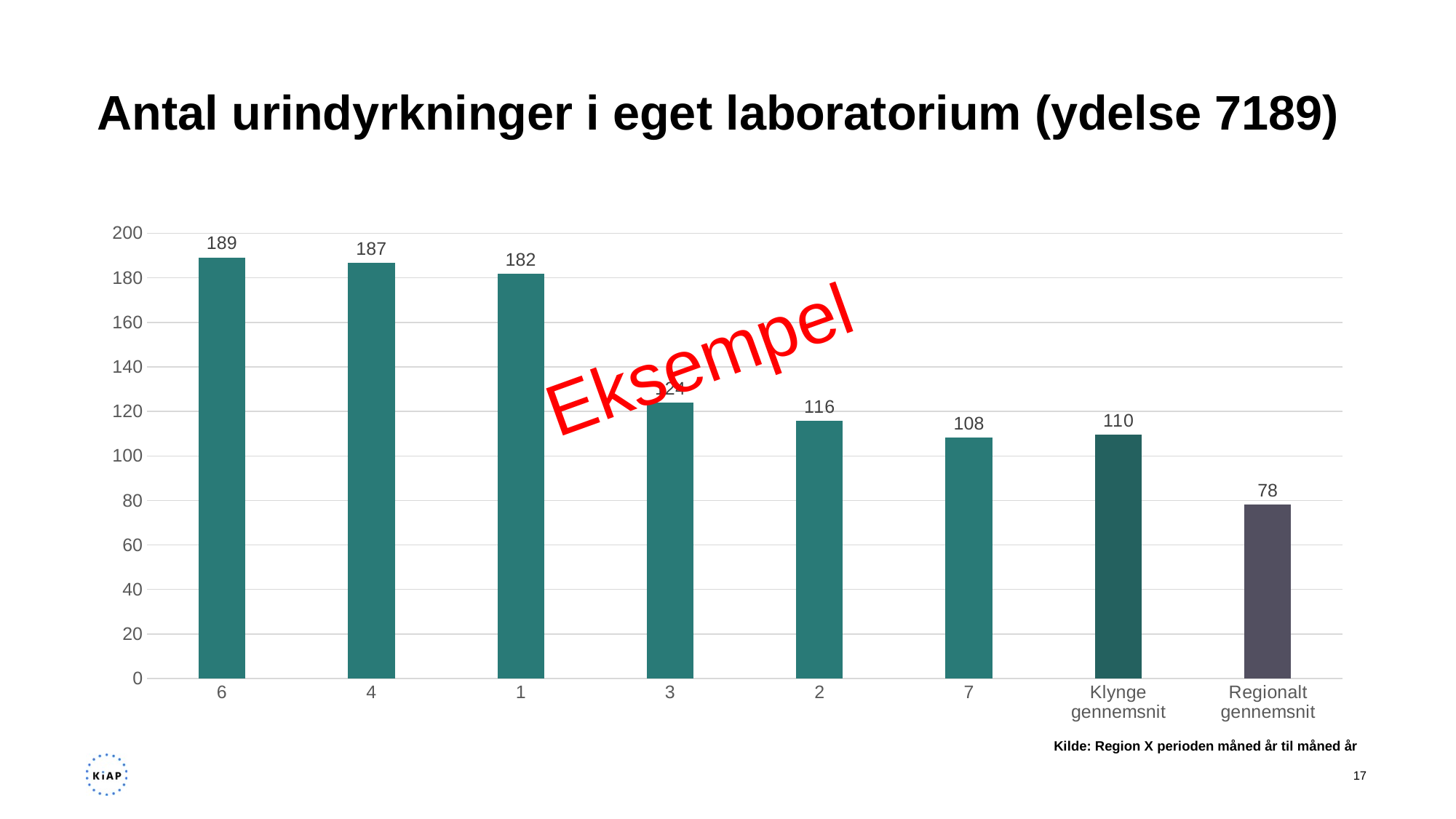
Which category has the lowest value? Regionalt gennemsnit What kind of chart is shown on the slide? bar chart What is the value for category 6? 189 What is the value for Klynge gennemsnit? 110 What is the value for category 2? 116 Which is larger, the value for Klynge gennemsnit or the value for category 7? Klynge gennemsnit What is the difference between the value for category 6 and the value for Regionalt gennemsnit? 111 What is the value for Regionalt gennemsnit? 78 How many bars are shown in the chart? 8 What is the difference between the value for category 2 and the value for category 7? 8 Is the value for category 3 greater or less than 140? less Which category has the highest value? 6